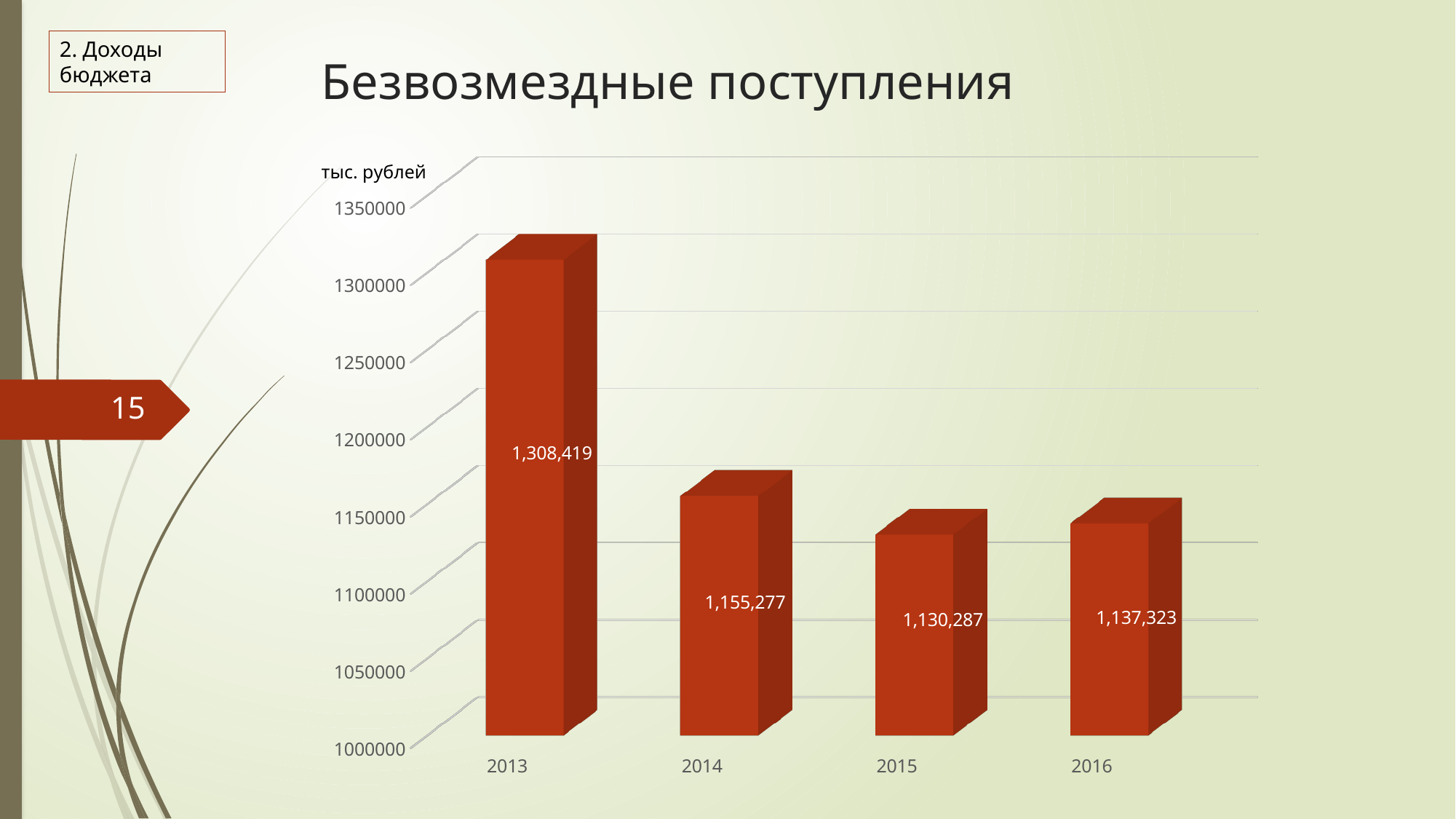
How many years are shown on the x axis of the chart? 4 What is the difference between the values for 2013 and 2014? 153,142 What is the value for 2013 in the chart? 1,308,419 What kind of chart is shown on the slide? Bar chart What is the difference between the values for 2016 and 2015? 7,036 What is the value for 2016 in the chart? 1,137,323 Which year has the highest value in the chart? 2013 Which year has the lowest value in the chart? 2015 What unit is indicated above the vertical axis of the chart? тыс. рублей Which is larger, the value for 2014 or the value for 2016? 2014 What is the value for 2015 in the chart? 1,130,287 Is the value for 2014 greater or less than 1150000? greater